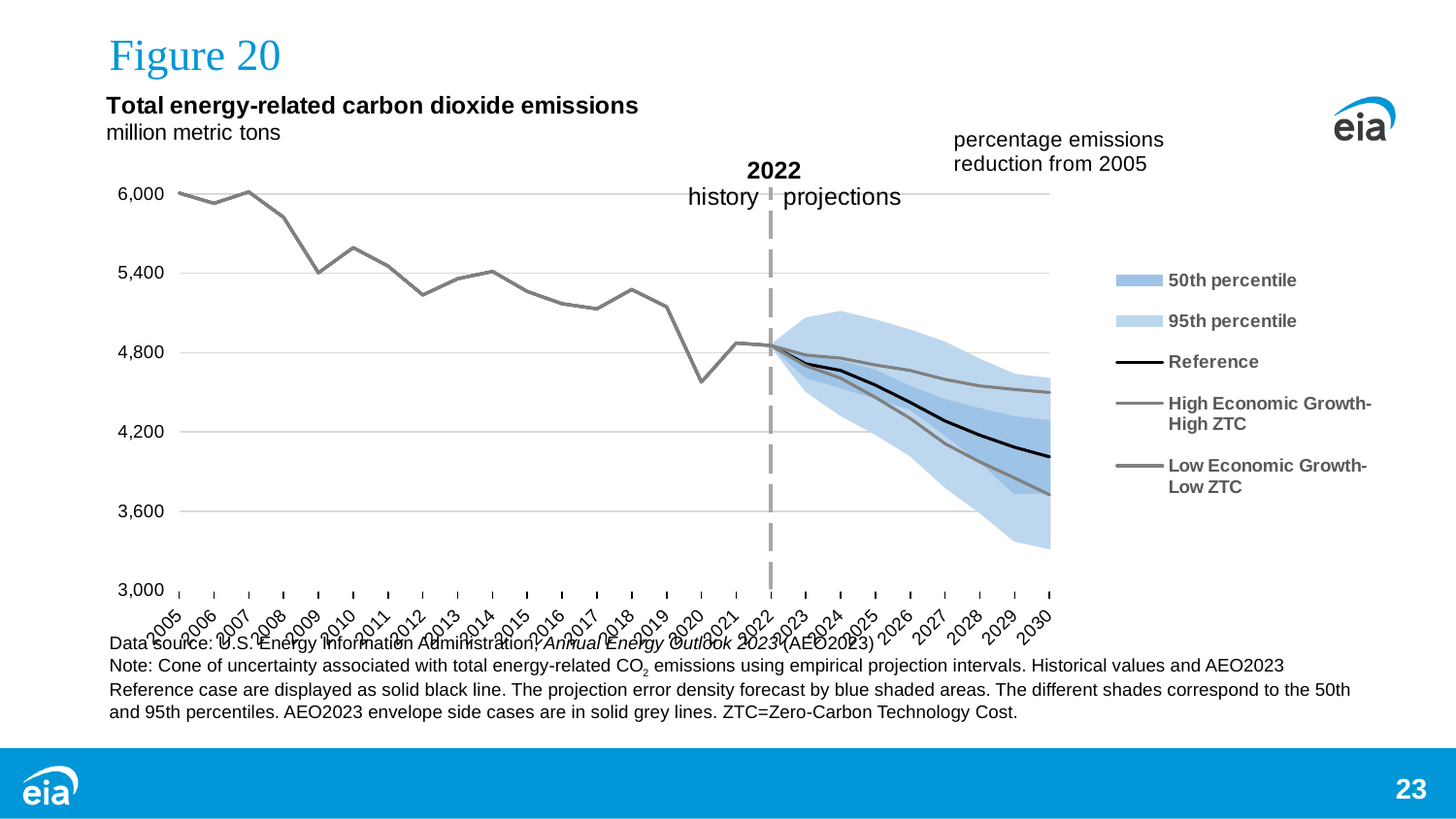
Is the Reference value for 2030 greater or less than 4,200? less What unit is shown under the chart title? million metric tons How many entries does the chart legend list? 5 Do emissions generally rise or fall from 2005 to 2030? fall What kind of chart is shown on the slide? line chart How many years are labeled along the x axis? 26 Is the High Economic Growth-High ZTC value for 2030 greater or less than 4,200? greater What is the title of the chart? Total energy-related carbon dioxide emissions Is the value for 2012 greater or less than 5,400? less Which year does the dashed vertical line separating history from projections mark? 2022